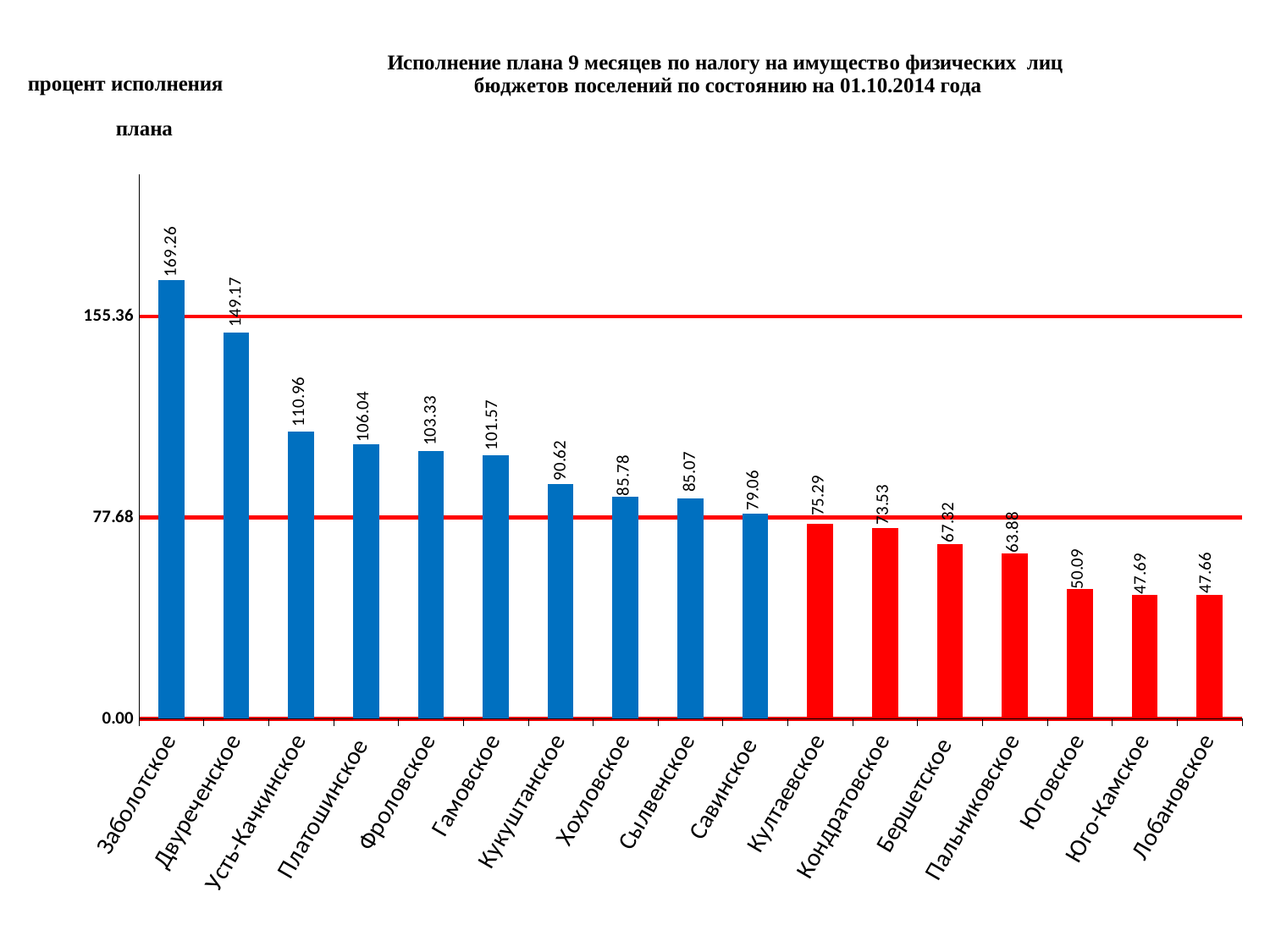
Is the value for Култаевское greater or less than 77.68? less What colour are the bars for settlements with values below 77.68? red Do the values rise or fall from left to right along the x axis? fall What is the value for Заболотское? 169.26 What kind of chart is shown on the slide? bar chart Which is larger, the value for Платошинское or the value for Фроловское? Платошинское Which settlement has the highest value? Заболотское What is the difference between the values for Заболотское and Двуреченское? 20.09 How many settlements are shown on the chart? 17 What is the value for Кукуштанское? 90.62 What is the value for Лобановское? 47.66 Which settlement has the lowest value? Лобановское